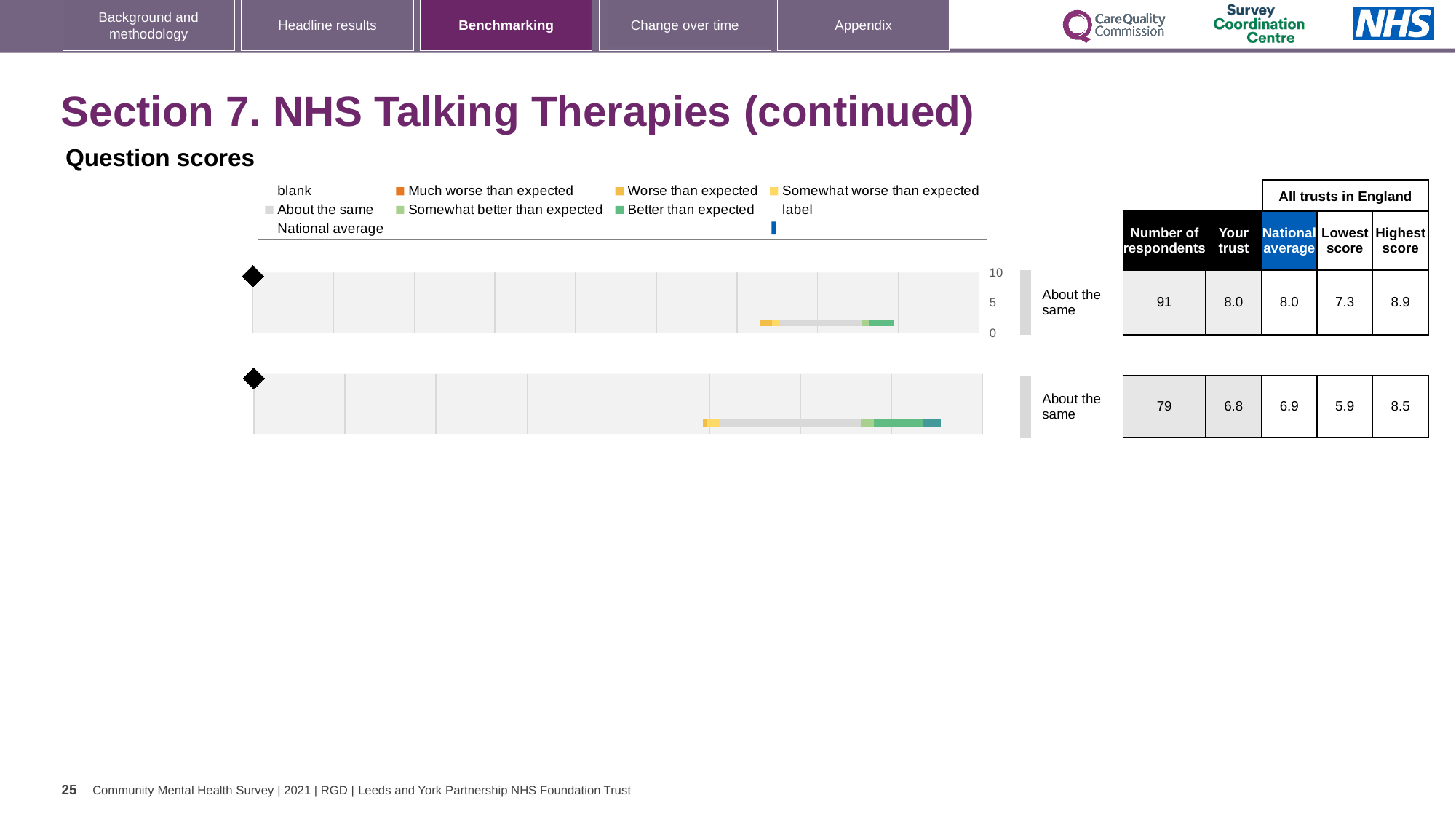
What is the heading above the 'National average', 'Lowest score' and 'Highest score' columns in the table? All trusts in England How many question score charts are shown on the slide? 2 For the top chart, what is the 'Your trust' score shown in the table? 8.0 What benchmark rating is given next to the bottom chart? About the same Which chart has more respondents, the top chart or the bottom chart? Top chart For the top chart, what is the difference between the highest score and the lowest score? 1.6 What kind of chart is used to show the question scores on this slide? bar chart For the bottom chart, what is the national average score? 6.9 For the bottom chart, what is the lowest score among all trusts in England? 5.9 In the legend, what colour represents 'Much worse than expected'? Orange For the bottom chart, which is larger: the 'Your trust' score or the national average? National average For the top chart, what is the number of respondents? 91